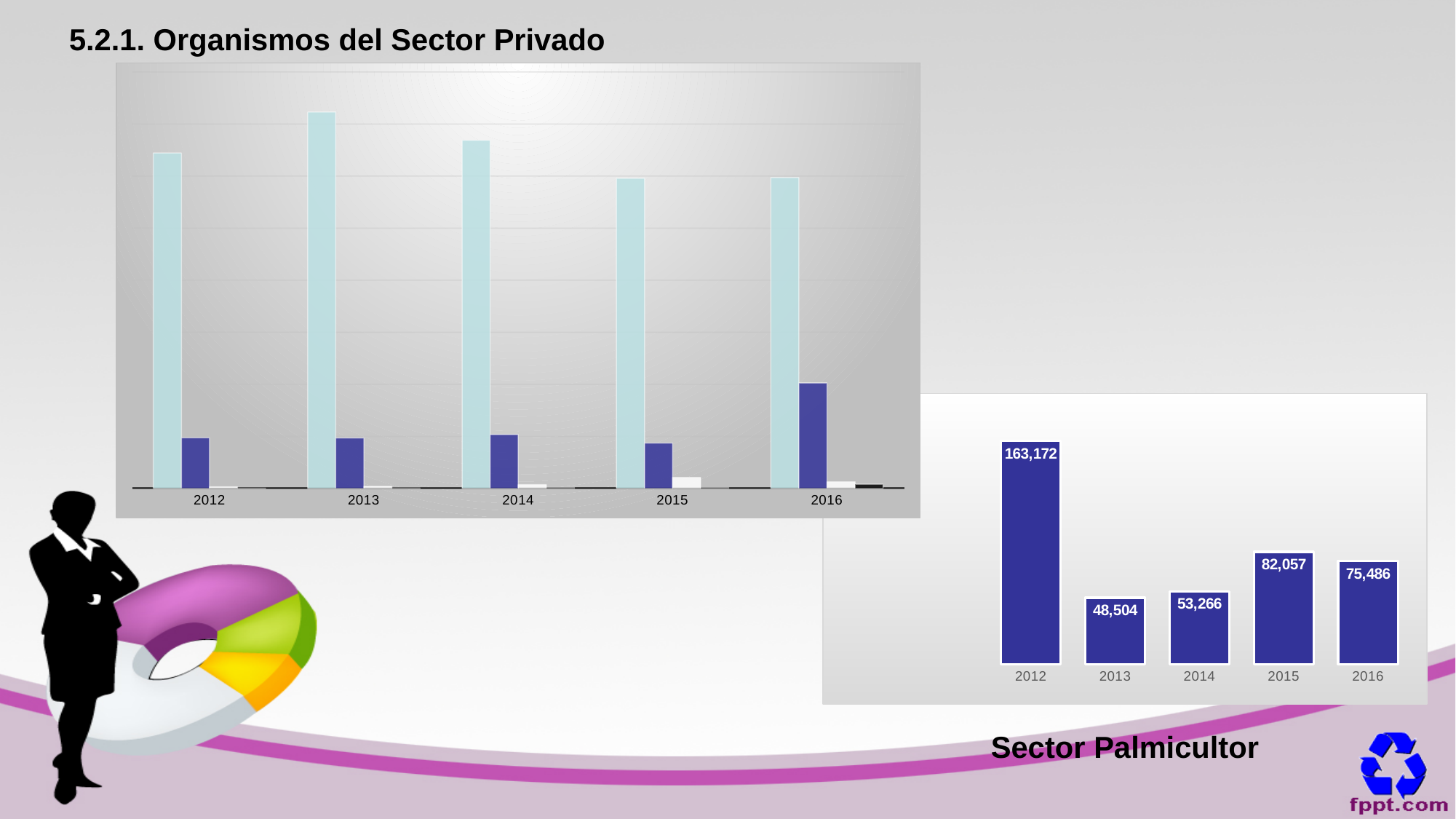
In the Sector Palmicultor chart, how many years are shown on the x axis? 5 In the Sector Palmicultor chart, what is the value for 2015? 82,057 In the Sector Palmicultor chart, which year has the lowest value? 2013 In the Sector Palmicultor chart, does the value rise or fall from 2012 to 2013? fall In the Sector Palmicultor chart, what is the value for 2012? 163,172 In the large chart on the left, in which year is the light blue bar tallest? 2013 In the Sector Palmicultor chart, what is the difference between the values for 2012 and 2013? 114,668 In the Sector Palmicultor chart, what is the value for 2016? 75,486 What kind of chart is the large chart on the left of the slide? bar chart In the Sector Palmicultor chart, what is the difference between the values for 2015 and 2016? 6,571 In the Sector Palmicultor chart, which is larger, the value for 2014 or the value for 2013? 2014 In the Sector Palmicultor chart, which year has the highest value? 2012